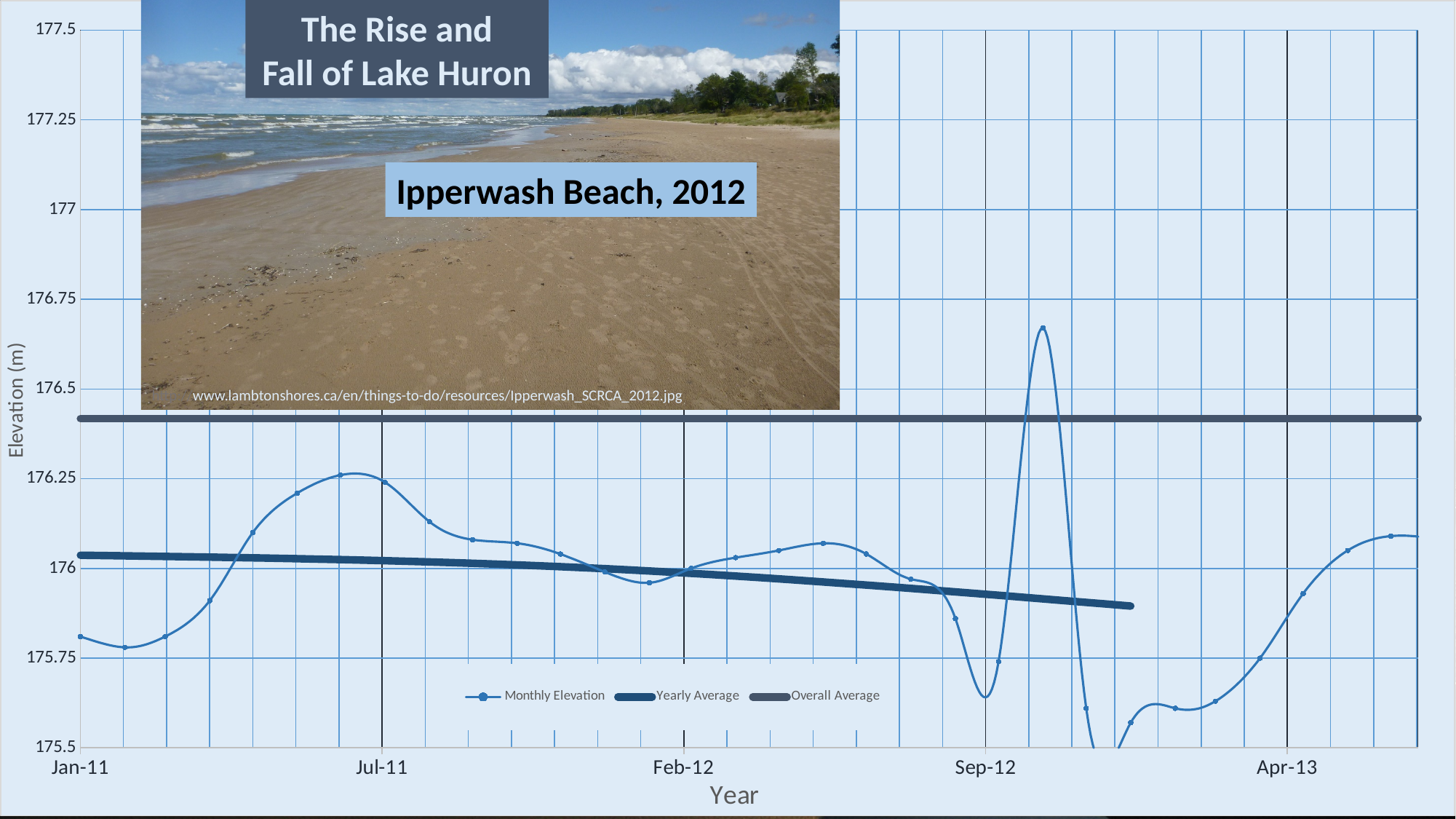
Is the highest Monthly Elevation value, reached shortly after Sep-12, greater or less than 176.5? greater Is the Overall Average line greater or less than 176.5? less Is the Monthly Elevation value at Apr-13 greater or less than 176? less What is the title of the chart on the slide? The Rise and Fall of Lake Huron How many date labels are shown on the x axis? 5 What is the label of the vertical axis? Elevation (m) Does the Yearly Average line rise or fall from left to right along the x axis? fall How many series does the chart legend list? 3 What kind of chart is shown on the slide? line chart